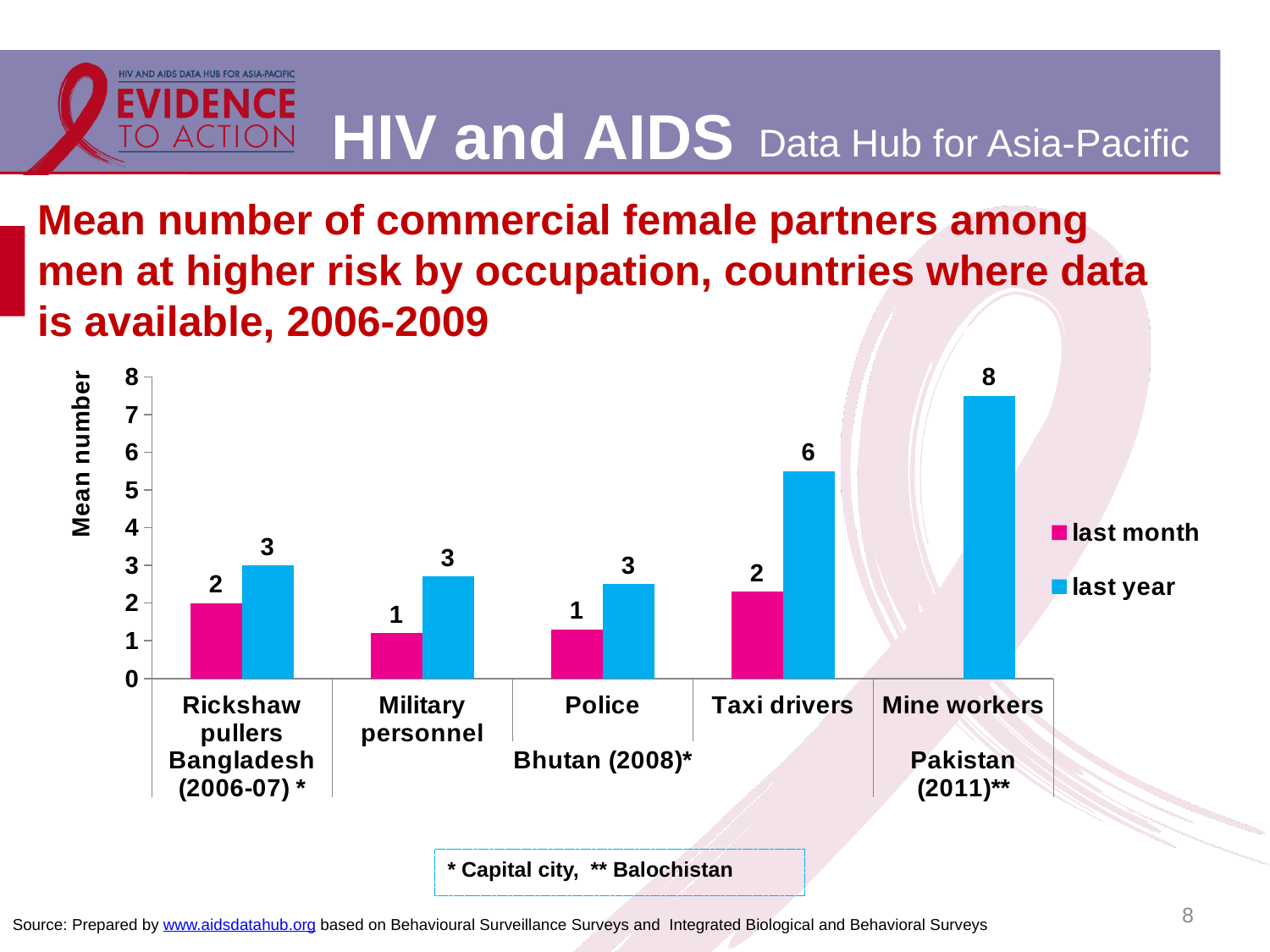
What is the difference between the last year and last month values for Taxi drivers? 4 Is the last year value for Mine workers greater or less than 6? greater What is the value for last year among Mine workers? 8 What kind of chart is shown on the slide? bar chart How many occupation categories are shown on the x axis? 5 How many series does the legend list? 2 Which occupation has the highest value for last year? Mine workers What is the difference between the last year values for Mine workers and Taxi drivers? 2 What is the value for last month among Taxi drivers? 2 What is the value for last month among Police? 1 What is the value for last year among Rickshaw pullers? 3 Which is larger: the last year value for Taxi drivers or the last year value for Rickshaw pullers? Taxi drivers